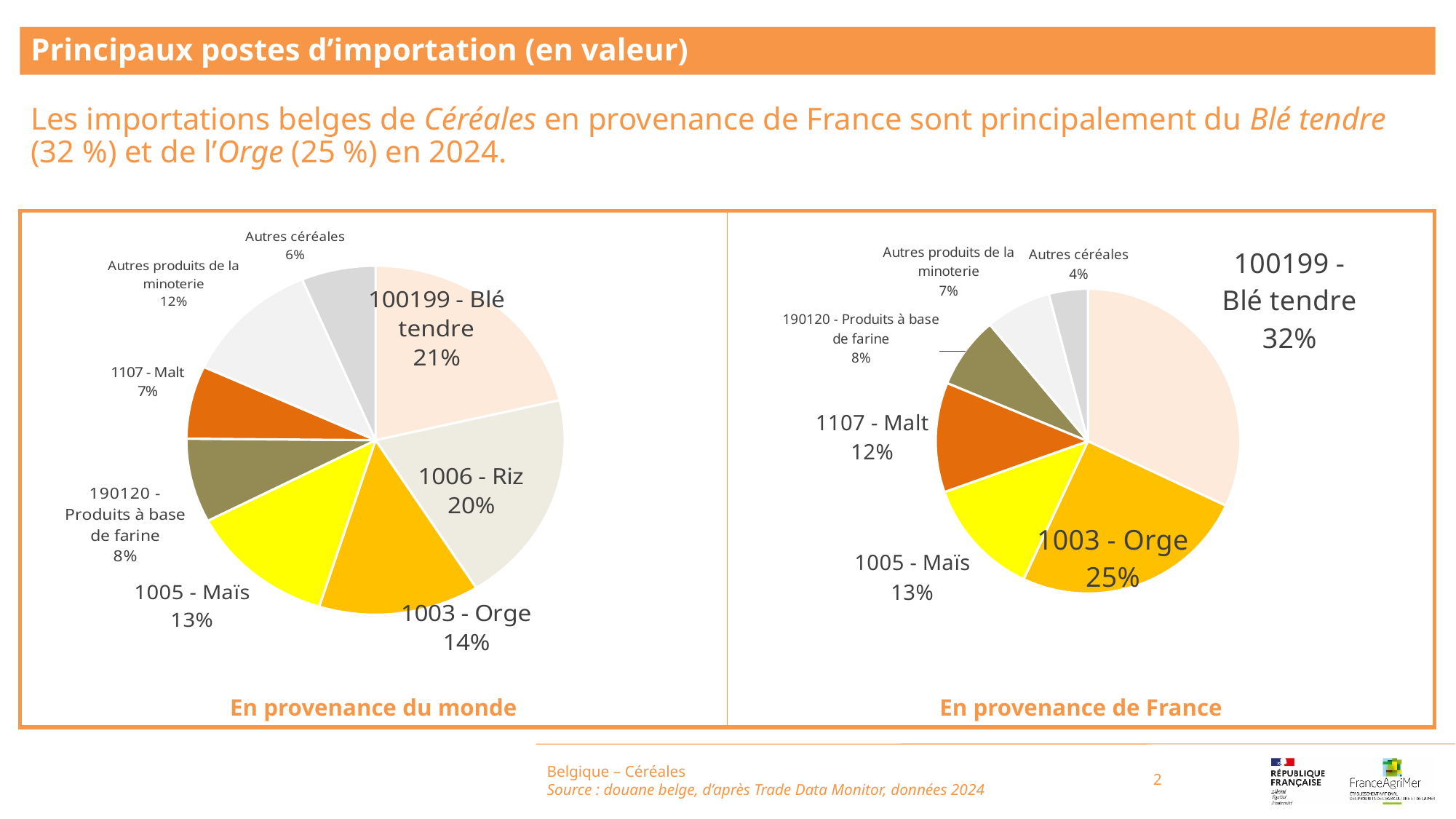
What is the difference between the share of '1003 - Orge' in the 'En provenance de France' chart and in the 'En provenance du monde' chart? 11 percentage points In the 'En provenance du monde' pie chart, which is larger: '1005 - Maïs' or '1107 - Malt'? 1005 - Maïs In the 'En provenance du monde' pie chart, which category has the smallest share? Autres céréales In the 'En provenance de France' pie chart, which category has the smallest share? Autres céréales In the 'En provenance du monde' pie chart, what share does '100199 - Blé tendre' have? 21% In the 'En provenance de France' pie chart, what share does '1003 - Orge' have? 25% How many slices does the 'En provenance du monde' pie chart have? 8 What type of chart is used on this slide? Pie chart In the 'En provenance de France' pie chart, what is the share of '1107 - Malt'? 12% In the 'En provenance de France' pie chart, which category has the largest share? 100199 - Blé tendre How many slices does the 'En provenance de France' pie chart have? 7 In the 'En provenance du monde' pie chart, what is the share of '1006 - Riz'? 20%